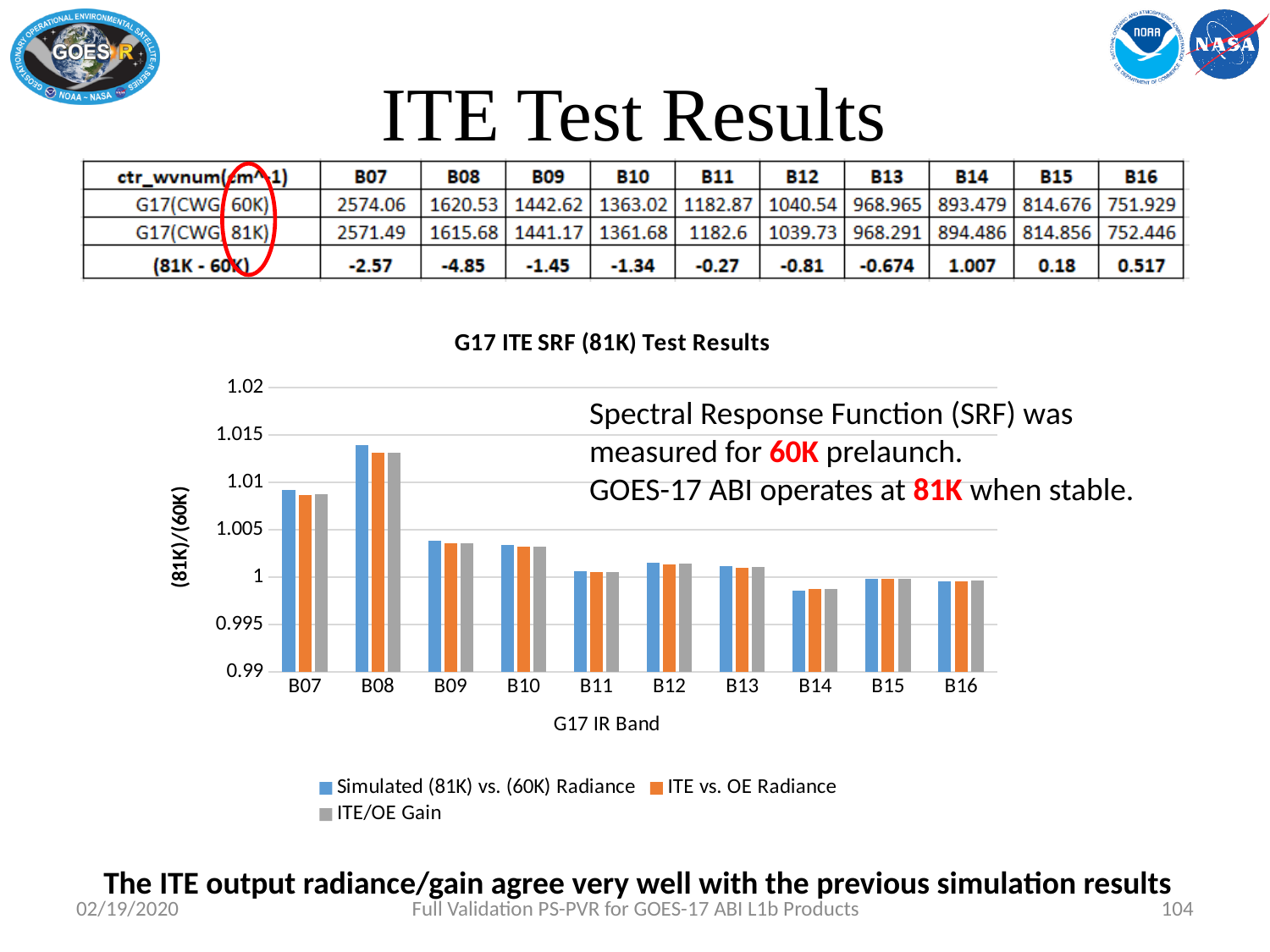
How many G17 IR bands are shown on the x axis of the chart? 10 Which band has the larger ITE vs. OE Radiance value, B07 or B08? B08 Which band has the lowest values in the chart? B14 What kind of chart is shown on the slide? bar chart What is the title of the chart? G17 ITE SRF (81K) Test Results Is the Simulated (81K) vs. (60K) Radiance value for B08 greater or less than 1.01? greater Is the ITE/OE Gain value for B14 greater or less than 1? less Do the values generally rise or fall from B08 to B14 along the x axis? fall How many series does the chart's legend list? 3 Is the ITE vs. OE Radiance value for B09 greater or less than 1.005? less Which band has the highest values in the chart? B08 What is the label of the x axis of the chart? G17 IR Band